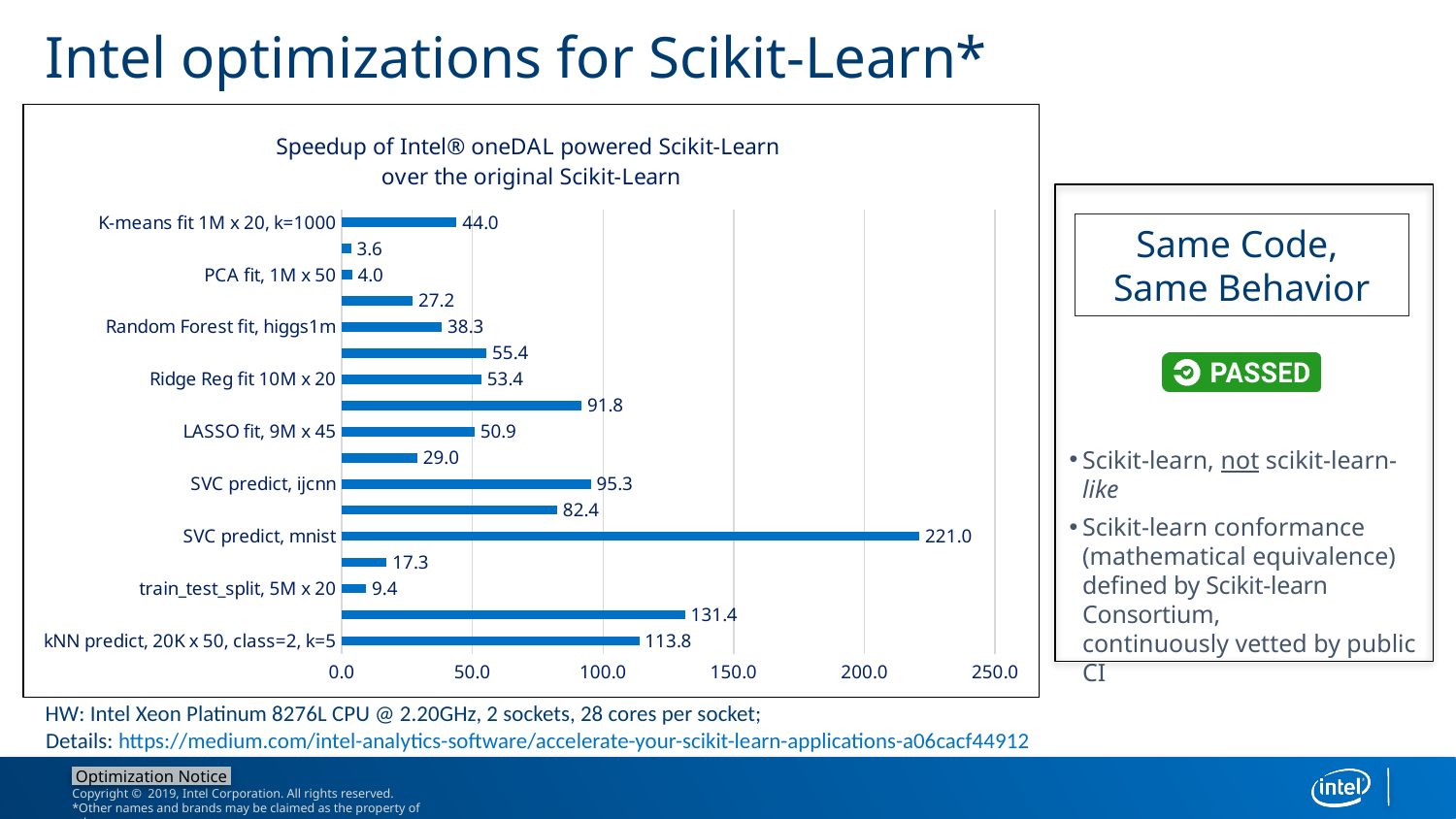
Which has a larger speedup: SVC predict, ijcnn or kNN predict, 20K x 50, class=2, k=5? kNN predict, 20K x 50, class=2, k=5 Which labeled category has the highest speedup? SVC predict, mnist What is the speedup value for kNN predict, 20K x 50, class=2, k=5? 113.8 What is the difference between the speedup for Ridge Reg fit 10M x 20 and the speedup for LASSO fit, 9M x 45? 2.5 How many bars are plotted in the chart? 17 What kind of chart is shown on the slide? bar chart Is the speedup for SVC predict, mnist greater or less than 200.0? greater What is the difference between the speedup for SVC predict, mnist and the speedup for kNN predict, 20K x 50, class=2, k=5? 107.2 What is the speedup value for Ridge Reg fit 10M x 20? 53.4 What is the speedup value for K-means fit 1M x 20, k=1000? 44.0 What is the speedup value for SVC predict, mnist? 221.0 What is the speedup value for train_test_split, 5M x 20? 9.4